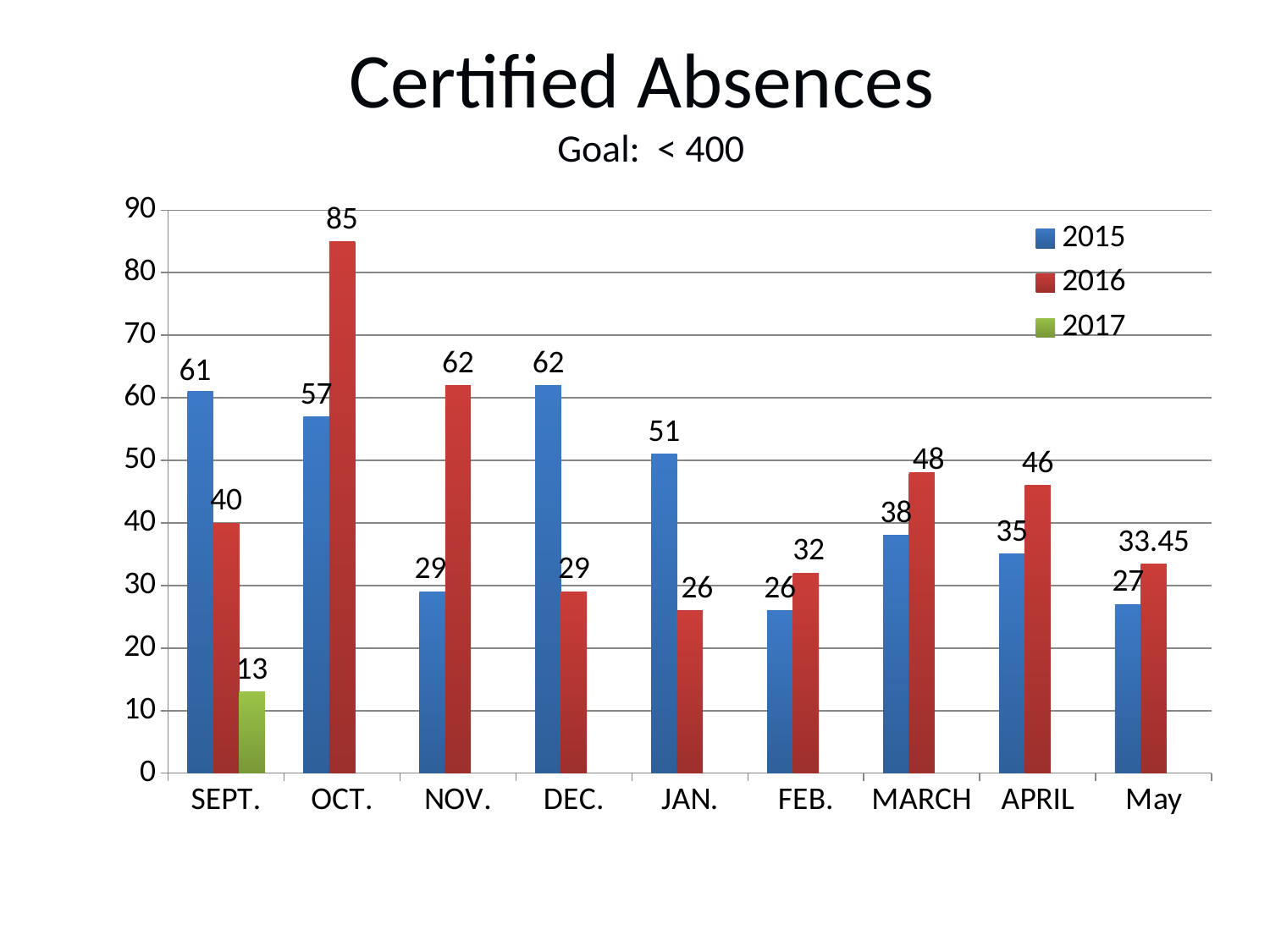
What is the 2017 value for SEPT.? 13 Which month has the highest 2016 value? OCT. What is the 2016 value for May? 33.45 What kind of chart is shown on the slide? Bar chart Which is larger for NOV., the 2015 value or the 2016 value? 2016 How many months are shown on the x axis? 9 What is the 2016 value for OCT.? 85 What is the 2015 value for DEC.? 62 What is the title of the chart? Certified Absences What is the difference between the 2016 and 2015 values for OCT.? 28 Which month has the lowest 2015 value? FEB. How many series does the legend list? 3